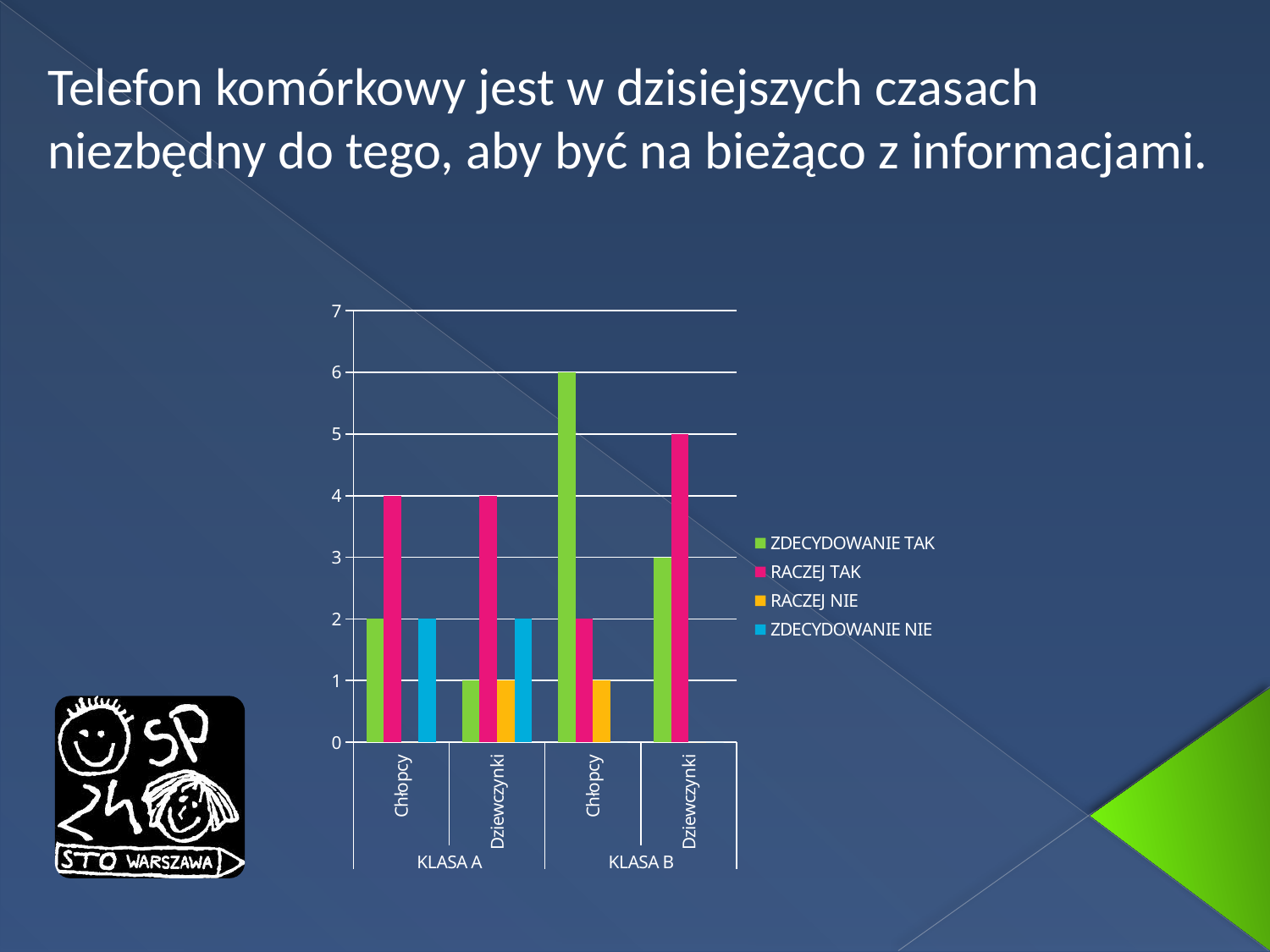
What is the difference between ZDECYDOWANIE TAK for Chłopcy in KLASA B and Chłopcy in KLASA A? 4 Which is larger for Dziewczynki in KLASA B: ZDECYDOWANIE TAK or RACZEJ TAK? RACZEJ TAK What kind of chart is shown on the slide? bar chart How many series does the legend list? 4 Which colour represents the RACZEJ NIE series in the legend? orange What is the value of RACZEJ TAK for Chłopcy in KLASA A? 4 Which group has the highest ZDECYDOWANIE TAK value? Chłopcy in KLASA B What is the value of ZDECYDOWANIE NIE for Dziewczynki in KLASA A? 2 How many groups (categories) are shown on the x axis? 4 What is the value of ZDECYDOWANIE TAK for Chłopcy in KLASA B? 6 What is the value of RACZEJ TAK for Dziewczynki in KLASA B? 5 Is the ZDECYDOWANIE TAK value for Chłopcy in KLASA B greater or less than 5? greater